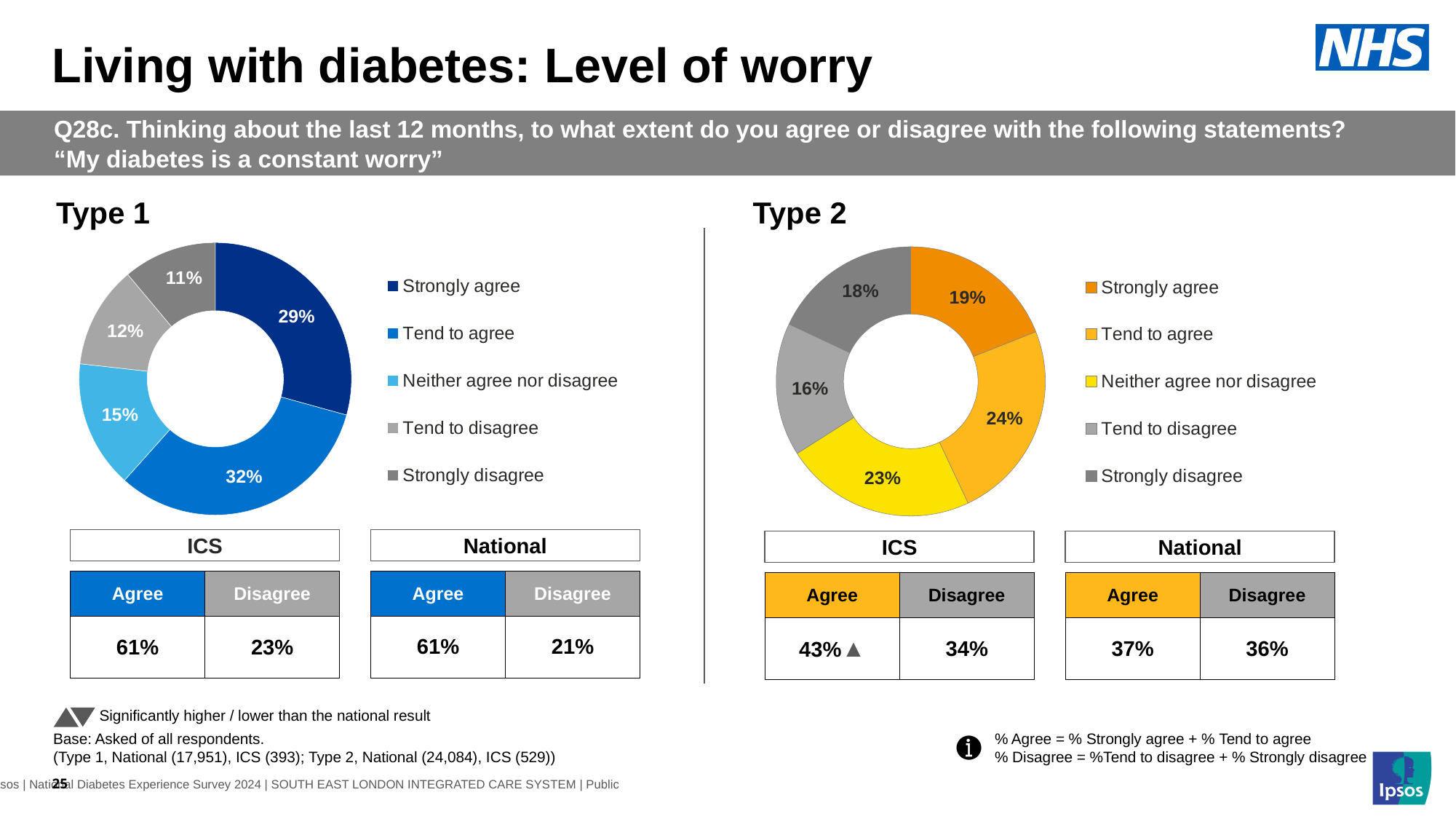
In the Type 1 chart, which category has the largest share? Tend to agree What kind of chart is the Type 1 chart? Doughnut chart In the Type 2 chart, what percentage is shown for Tend to disagree? 16% How many categories does the Type 2 chart show? 5 In the Type 1 chart, what percentage is shown for Tend to agree? 32% In the Type 2 chart, which category has the smallest share? Tend to disagree In the Type 2 chart, what is the combined share of Strongly agree and Tend to agree? 43% In the Type 2 chart, what percentage is shown for Neither agree nor disagree? 23% In the Type 1 chart, what is the difference between the Strongly agree and Strongly disagree shares? 18% In the Type 2 chart, which is larger: Strongly agree or Tend to agree? Tend to agree In the Type 1 chart, what percentage is shown for Strongly disagree? 11% In the Type 1 chart, what colour is the Neither agree nor disagree slice? Light blue